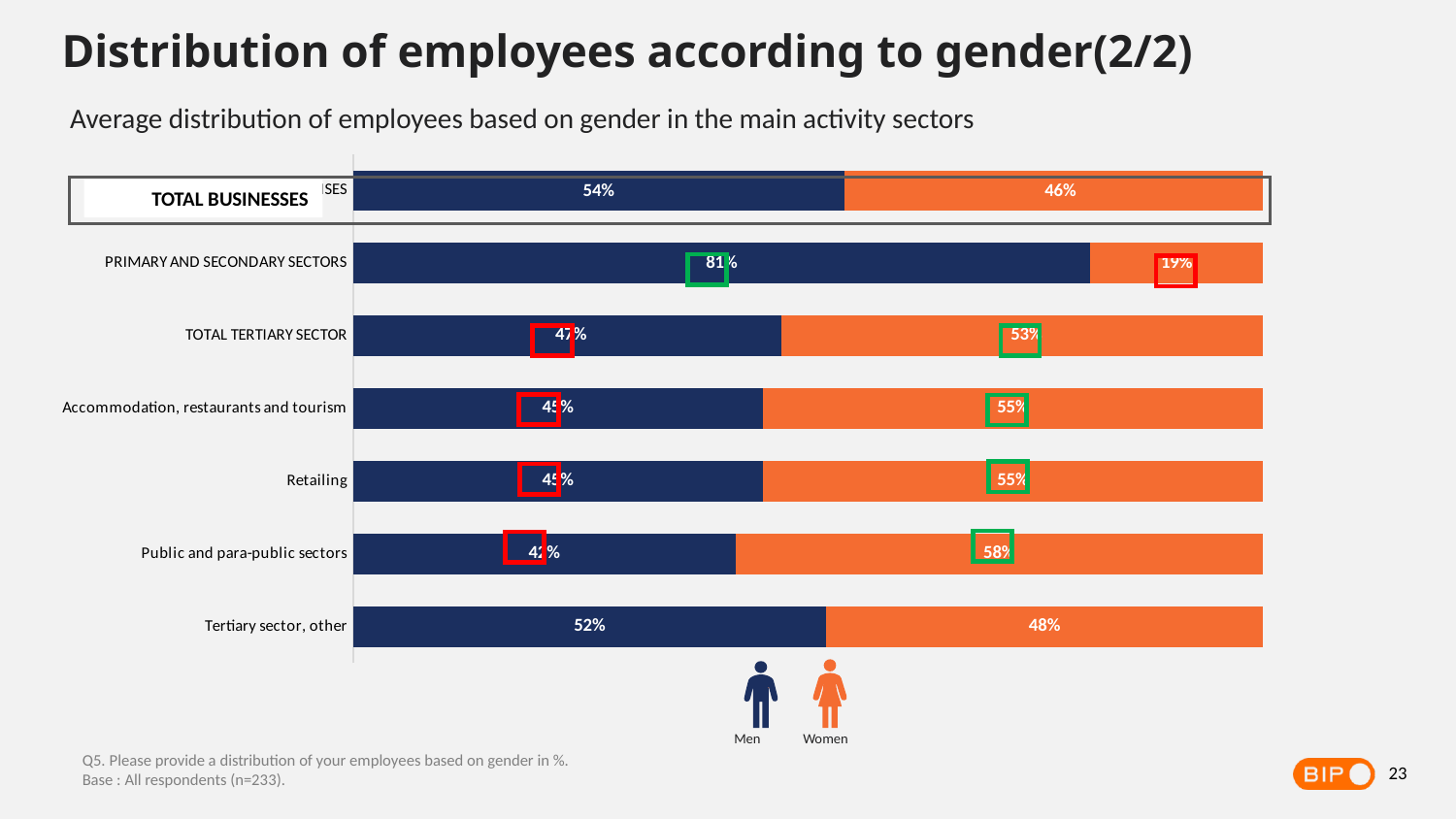
How many series does the chart's legend show? 2 What percentage of employees are men in the Primary and Secondary Sectors? 81% Which sector has the highest percentage of men employees? Primary and Secondary Sectors What percentage of employees are women in the Total Tertiary Sector? 53% What percentage of employees are women in the Public and para-public sectors? 58% What percentage of employees are men in the 'Tertiary sector, other' category? 52% What is the share of women employees for Total Businesses? 46% Which sector has the lowest percentage of women employees? Primary and Secondary Sectors How many sector categories are shown in the chart? 7 What type of chart is shown on the slide? Stacked bar chart For Total Businesses, is the share of men or women larger? Men By how many percentage points does the men's share exceed the women's share in the Primary and Secondary Sectors? 62 percentage points